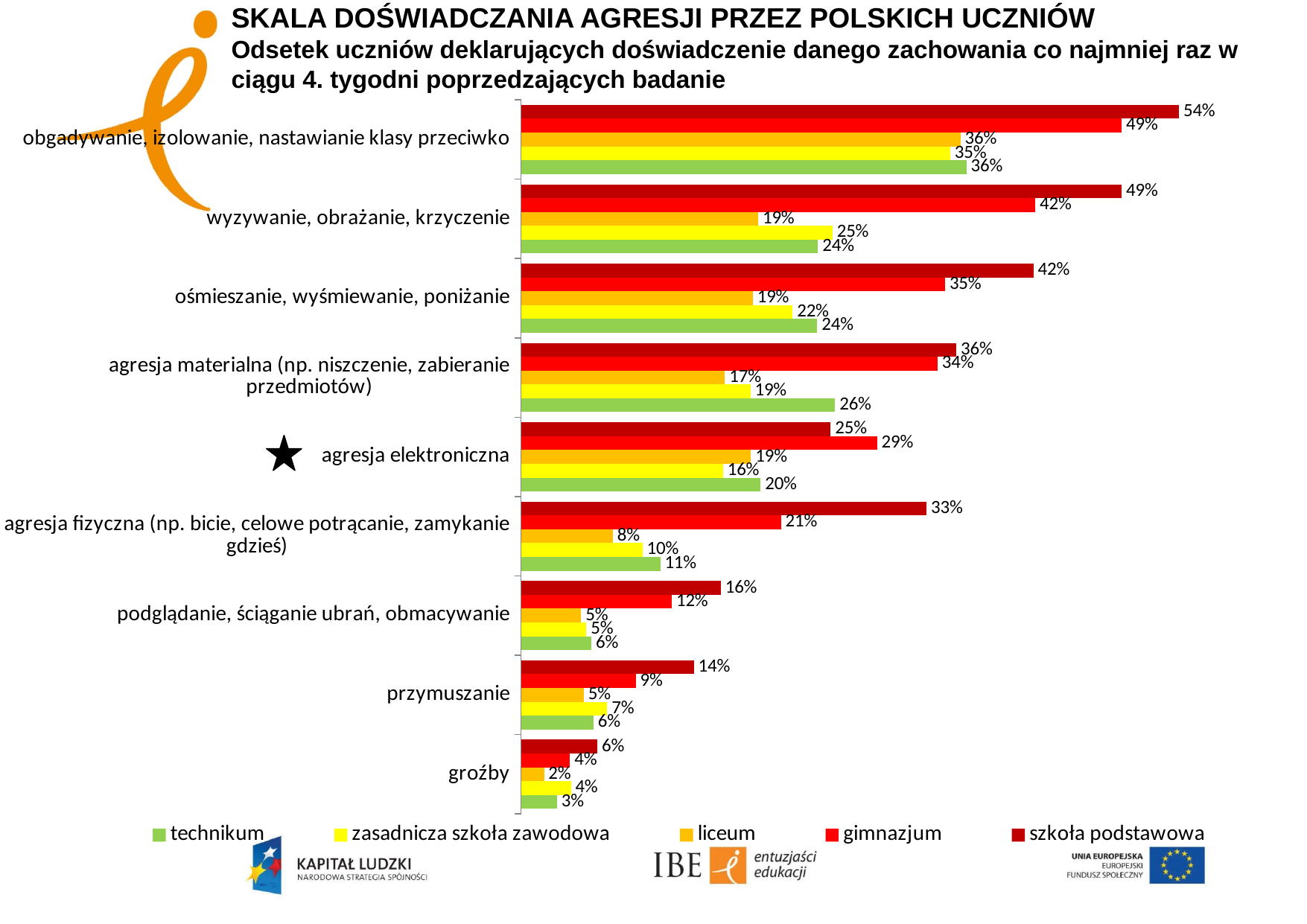
What kind of chart is shown on the slide? bar chart Which colour represents technikum in the legend? green What percentage of szkoła podstawowa students reported experiencing "obgadywanie, izolowanie, nastawianie klasy przeciwko"? 54% Which category has the highest value for szkoła podstawowa? obgadywanie, izolowanie, nastawianie klasy przeciwko In the "agresja elektroniczna" category, which is larger: the value for gimnazjum or for szkoła podstawowa? gimnazjum How many series does the legend list? 5 What is the value for liceum in the "groźby" category? 2% How many categories of aggressive behaviour are shown on the chart? 9 What is the value for technikum in the "agresja materialna (np. niszczenie, zabieranie przedmiotów)" category? 26% Which category has the lowest value for gimnazjum? groźby What is the value for gimnazjum in the "agresja elektroniczna" category? 29% What is the difference between the szkoła podstawowa and gimnazjum values for "agresja fizyczna (np. bicie, celowe potrącanie, zamykanie gdzieś)"? 12%